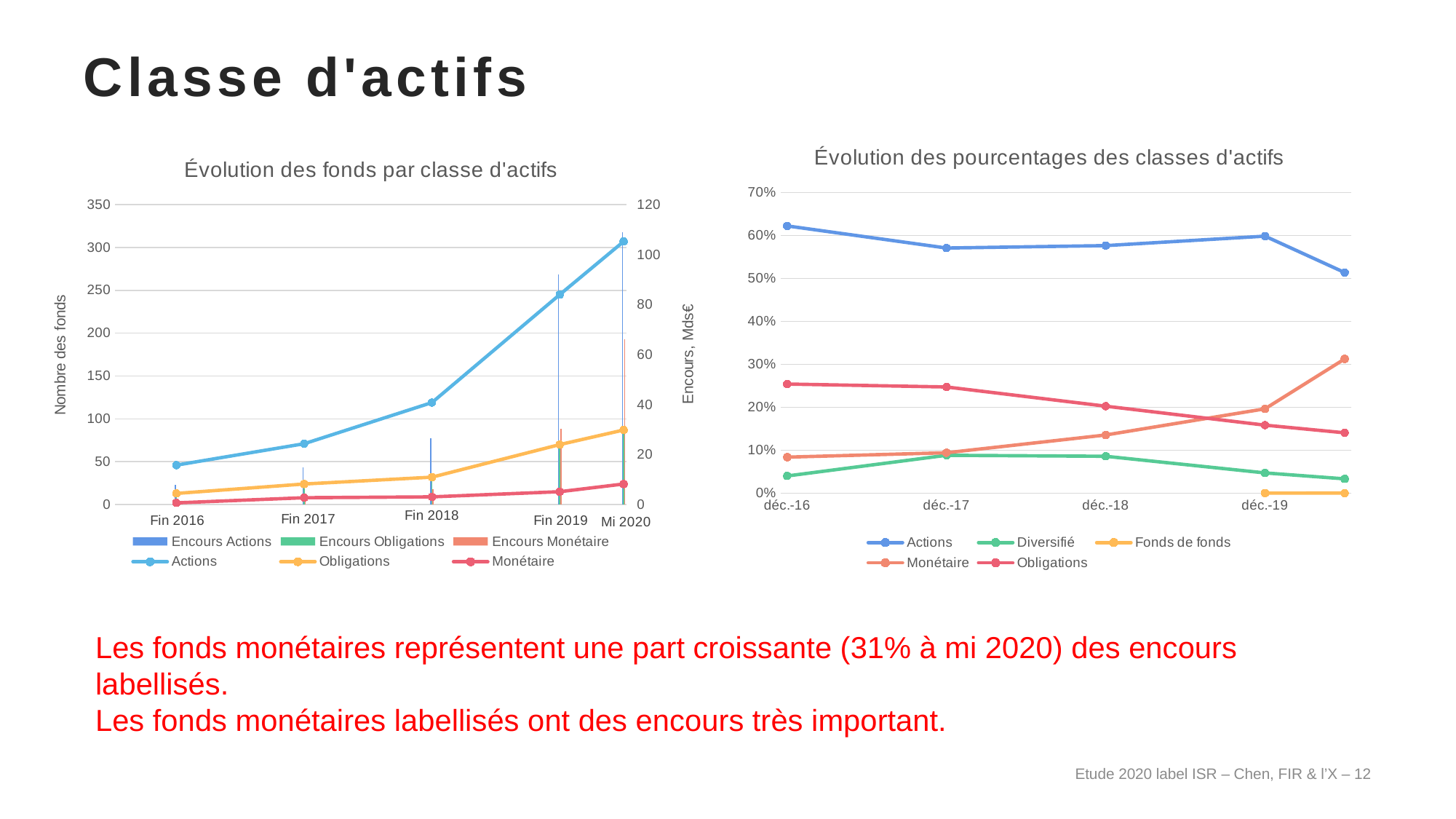
In the chart 'Évolution des fonds par classe d'actifs', is the number of Actions funds at Fin 2018 greater or less than 100? greater In the chart 'Évolution des fonds par classe d'actifs', is the number of Actions funds at Mi 2020 greater or less than 300? greater In the chart 'Évolution des fonds par classe d'actifs', how many time periods are shown on the x axis? 5 In the chart 'Évolution des fonds par classe d'actifs', how many series does the legend list? 6 In the chart 'Évolution des pourcentages des classes d'actifs', which series has the highest value at déc.-16? Actions In the chart 'Évolution des fonds par classe d'actifs', what is the label of the right-hand vertical axis? Encours, Mds€ In the chart 'Évolution des fonds par classe d'actifs', at Mi 2020, which line is higher: Obligations or Monétaire? Obligations In the chart 'Évolution des pourcentages des classes d'actifs', which series has the lowest value at déc.-19? Fonds de fonds In the chart 'Évolution des pourcentages des classes d'actifs', does the Obligations line rise or fall from déc.-16 to the last point? fall In the chart 'Évolution des pourcentages des classes d'actifs', how many series does the legend list? 5 In the chart 'Évolution des fonds par classe d'actifs', does the Actions line rise or fall from Fin 2016 to Mi 2020? rise In the chart 'Évolution des pourcentages des classes d'actifs', is the Actions value at déc.-16 greater or less than 60%? greater